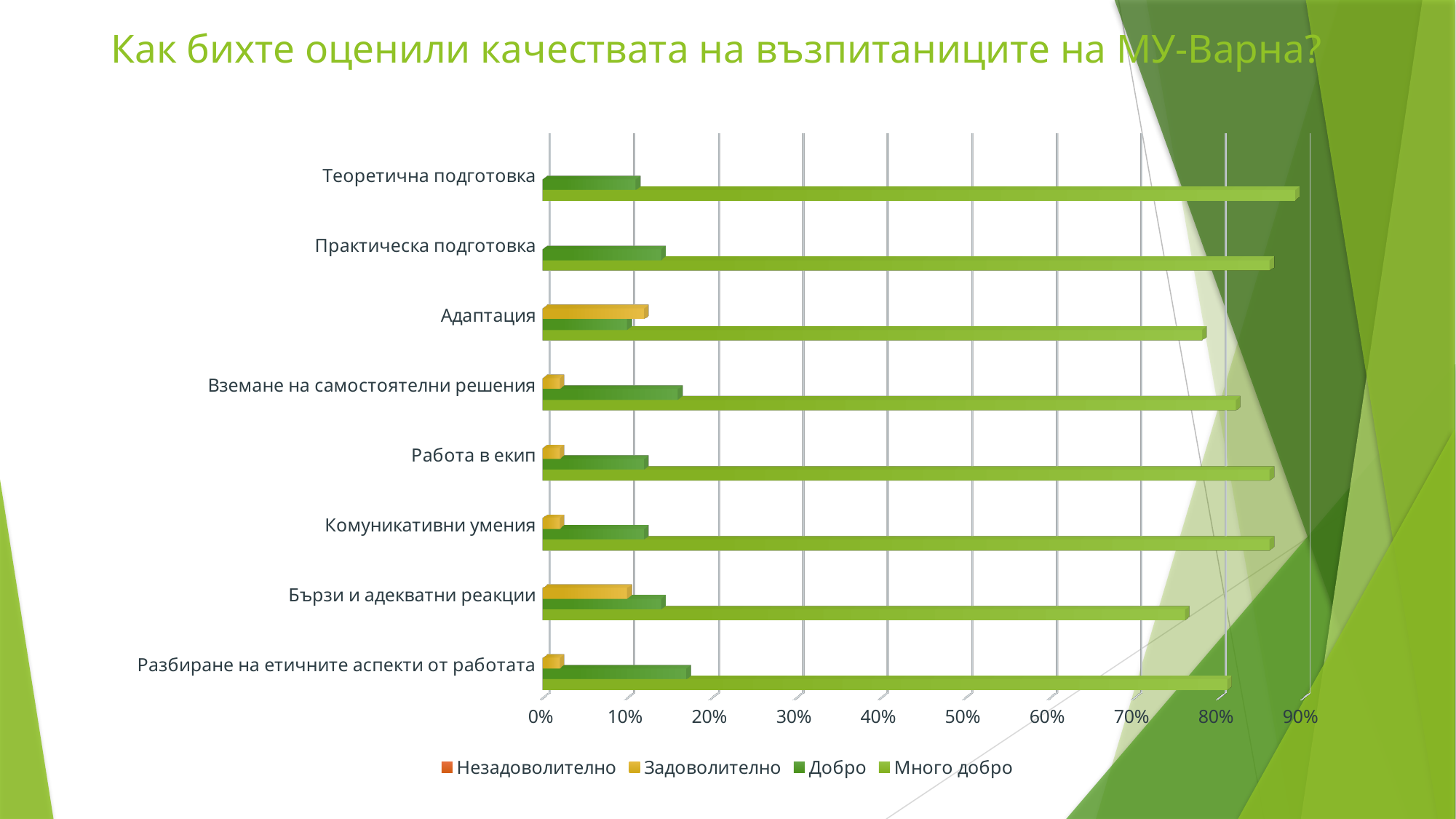
Is the value for Много добро for Бързи и адекватни реакции greater or less than 80%? less Is the value for Много добро for Теоретична подготовка greater or less than 80%? greater How many categories are plotted on the chart? 8 What is the title of the chart? Как бихте оценили качествата на възпитаниците на МУ-Варна? Which category has the highest value for the series Много добро? Теоретична подготовка Is the value for Задоволително for Адаптация greater or less than 20%? less Which is larger: the Много добро value for Теоретична подготовка or for Бързи и адекватни реакции? Теоретична подготовка How many series does the legend list? 4 Which is larger: the Добро value for Разбиране на етичните аспекти от работата or for Теоретична подготовка? Разбиране на етичните аспекти от работата Which series is shown in yellow in the legend? Задоволително What kind of chart is shown on the slide? bar chart